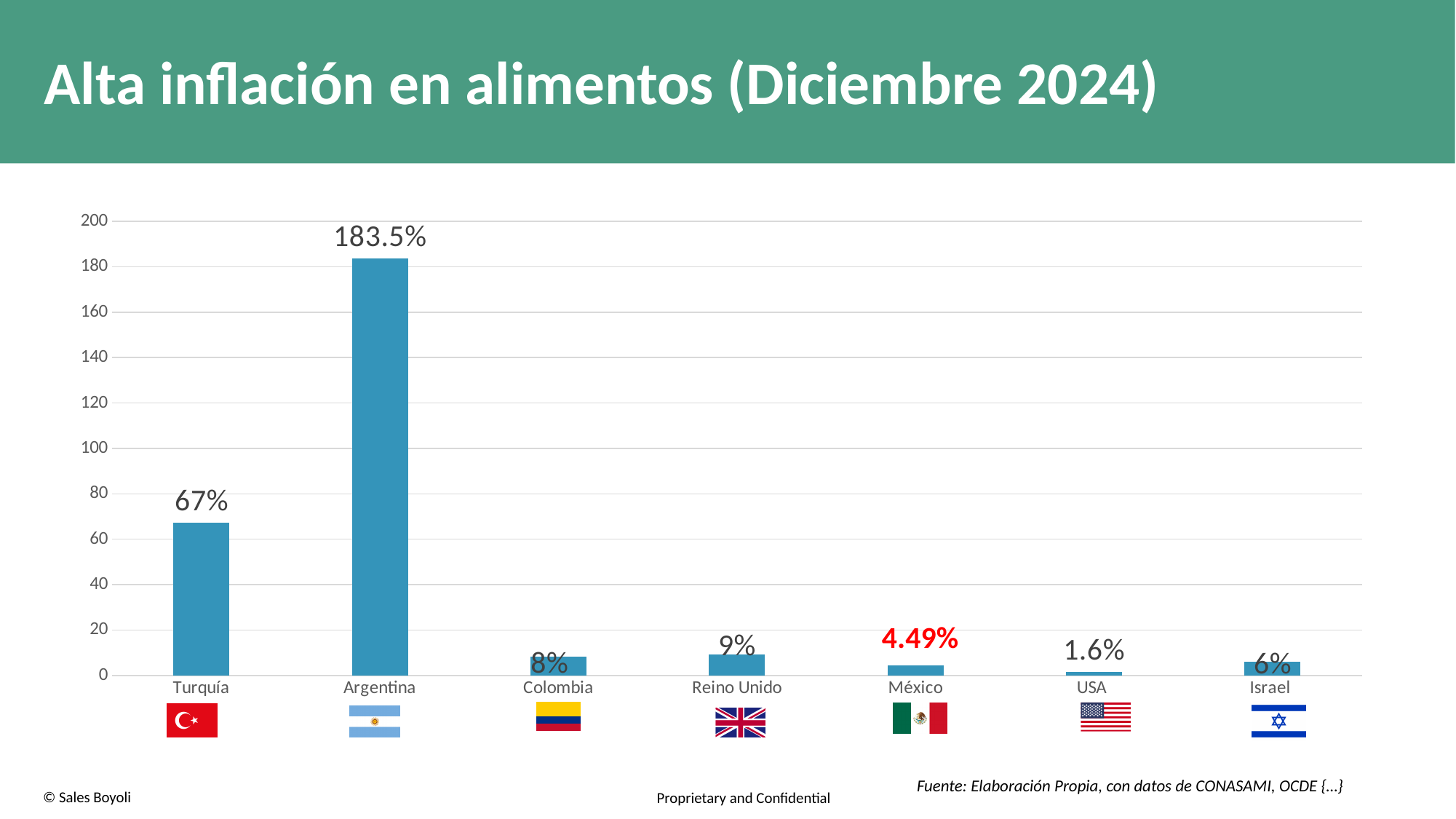
How many countries are shown on the chart? 7 What is the value shown for Argentina? 183.5% Which country has the lowest value? USA What is the value shown for Turquía? 67% Which is larger, the value for Reino Unido or the value for Colombia? Reino Unido What is the title of the slide? Alta inflación en alimentos (Diciembre 2024) What is the value shown for México? 4.49% What is the difference between the values for Argentina and Turquía? 116.5% Is the value for Turquía greater or less than 60? greater What kind of chart is shown on the slide? Bar chart Which country has the highest value? Argentina What is the value shown for USA? 1.6%